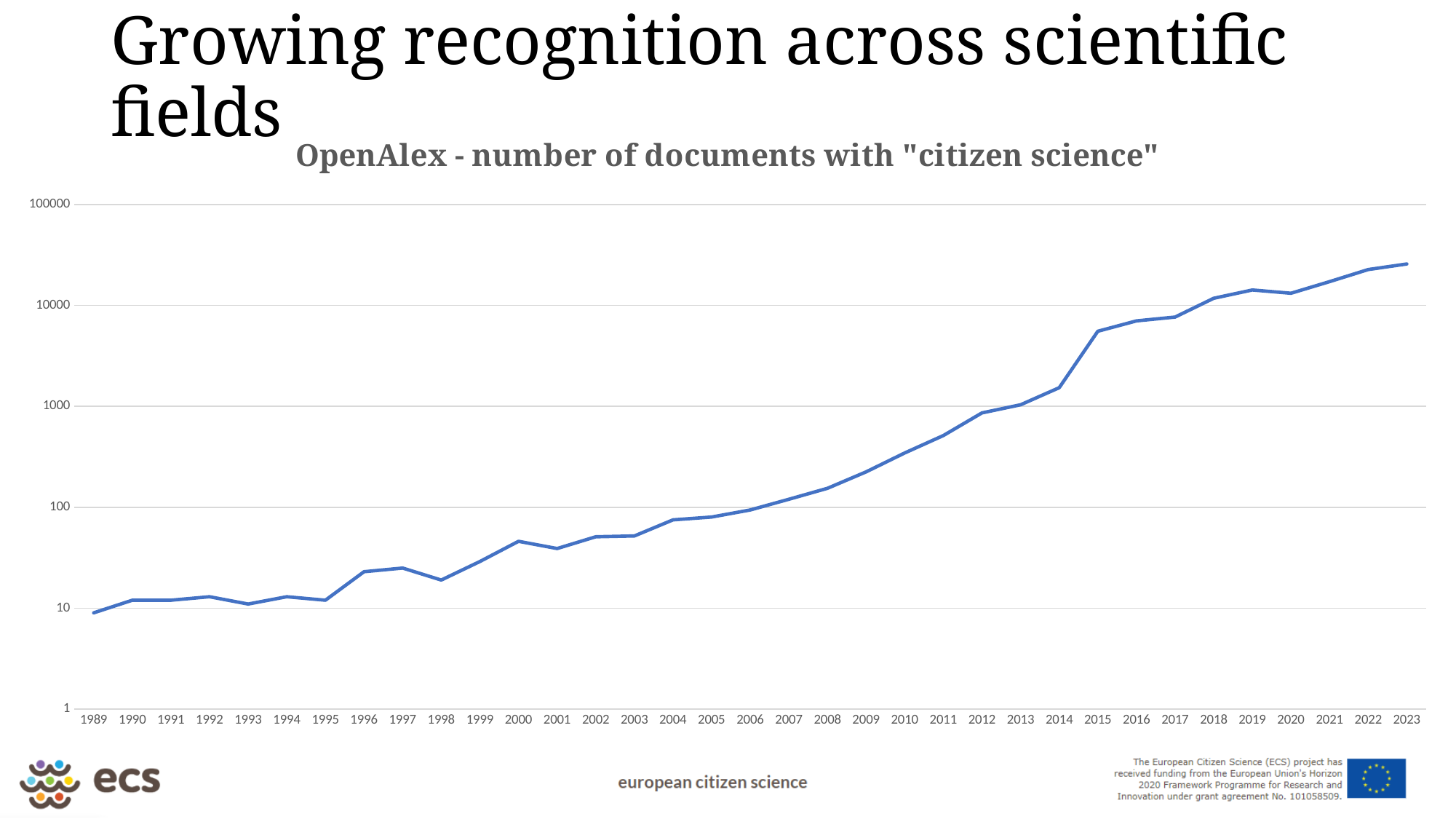
Do the values generally rise or fall from 1989 to 2023? rise Which year has the larger value, 2010 or 2015? 2015 What is the title of the chart? OpenAlex - number of documents with "citizen science" Is the value for 2008 greater or less than 100? greater Which year has the lowest number of documents? 1989 Is the value for 2023 greater or less than 10000? greater Which year has the highest number of documents? 2023 Is the value for 2015 greater or less than 1000? greater What kind of chart is shown on the slide? line chart How many years are plotted along the x axis of the chart? 35